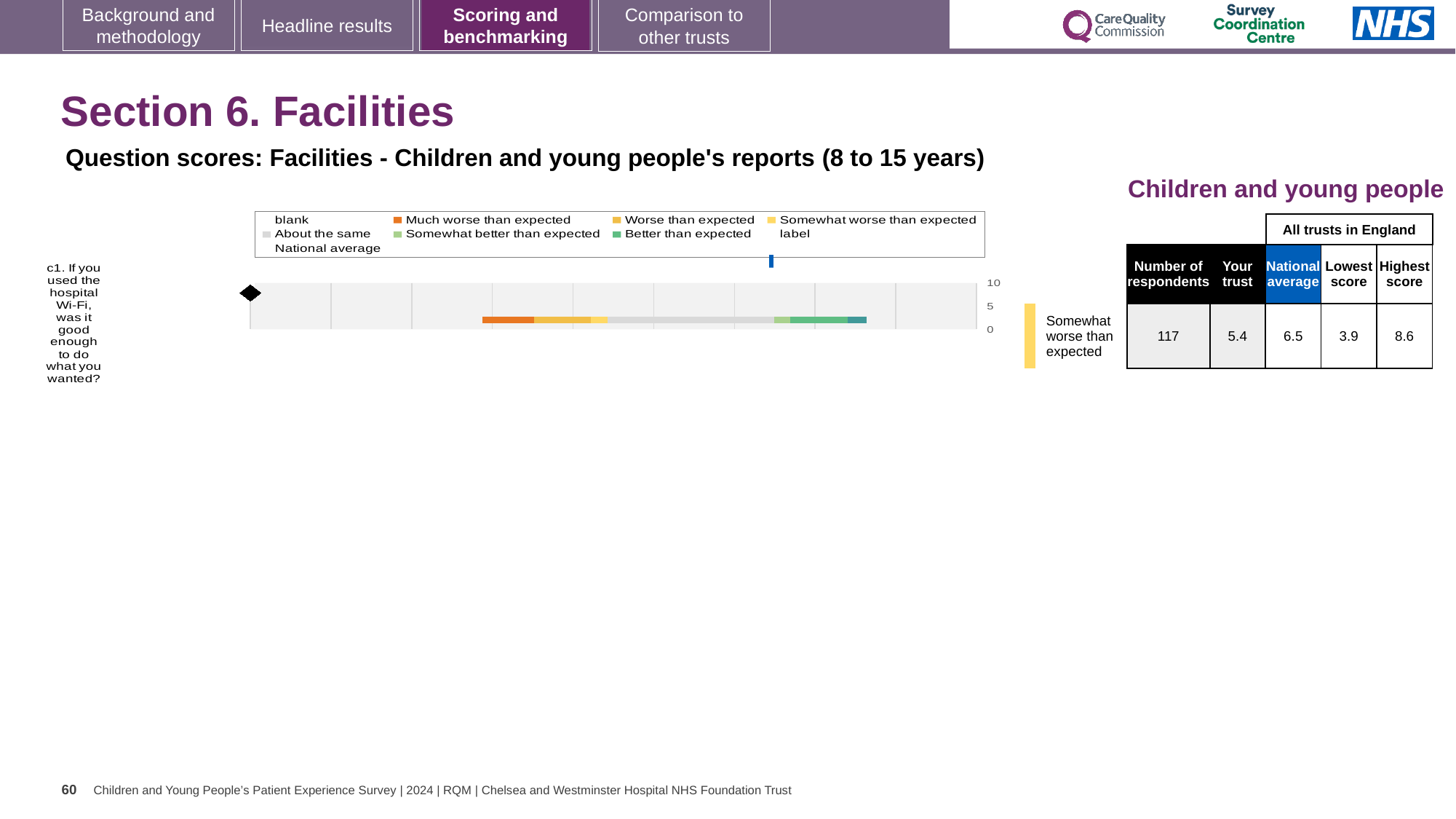
Which benchmark band is the trust's score for c1 placed in? Somewhat worse than expected What is the national average score for c1 shown next to the chart? 6.5 Which question is plotted in the chart? c1. If you used the hospital Wi-Fi, was it good enough to do what you wanted? How many respondents answered question c1? 117 How many entries does the chart legend list? 9 What is the highest score among all trusts in England for c1? 8.6 What is the difference between the highest score and the lowest score for c1? 4.7 What kind of chart is used to show the question score for c1 on this slide? bar chart How many questions are plotted in the chart on this slide? 1 What is the 'Your trust' score for c1 shown next to the chart? 5.4 Which is larger for c1, the 'Your trust' score or the national average? National average What is the lowest score among all trusts in England for c1? 3.9